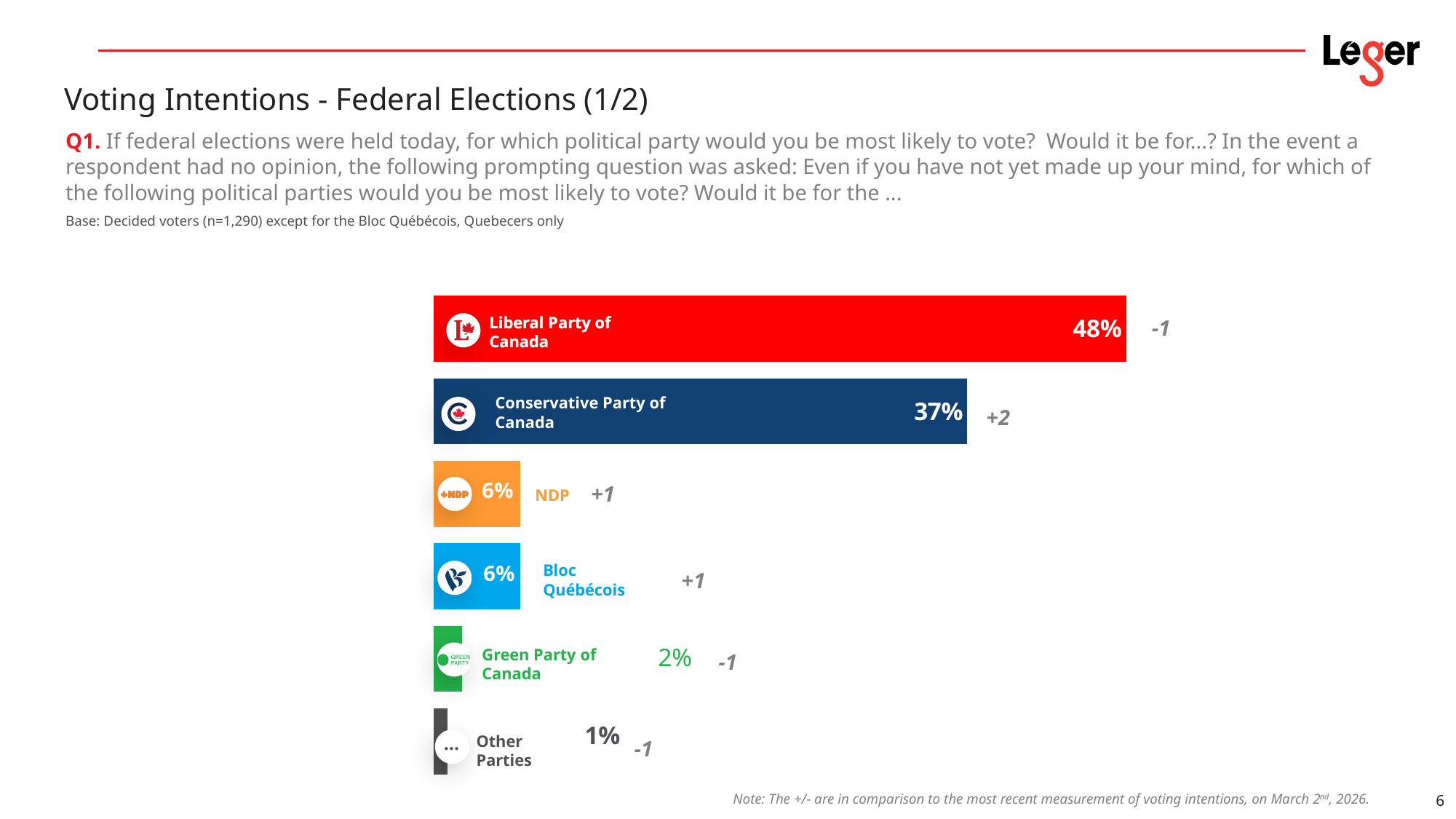
Which has a larger value, the NDP or the Green Party of Canada? NDP What colour is the bar for the Liberal Party of Canada? Red What percentage is shown for the Green Party of Canada? 2% Which category has the lowest value on the chart? Other Parties How many parties or categories are shown on the chart? 6 What percentage of decided voters would vote for the Liberal Party of Canada? 48% What is the value shown for the Conservative Party of Canada? 37% What is the value for Other Parties? 1% What is the change shown next to the Conservative Party of Canada compared to the previous measurement? +2 What kind of chart is shown on the slide? Bar chart Which party has the highest voting intention? Liberal Party of Canada What is the difference in percentage points between the Liberal Party of Canada and the Conservative Party of Canada? 11